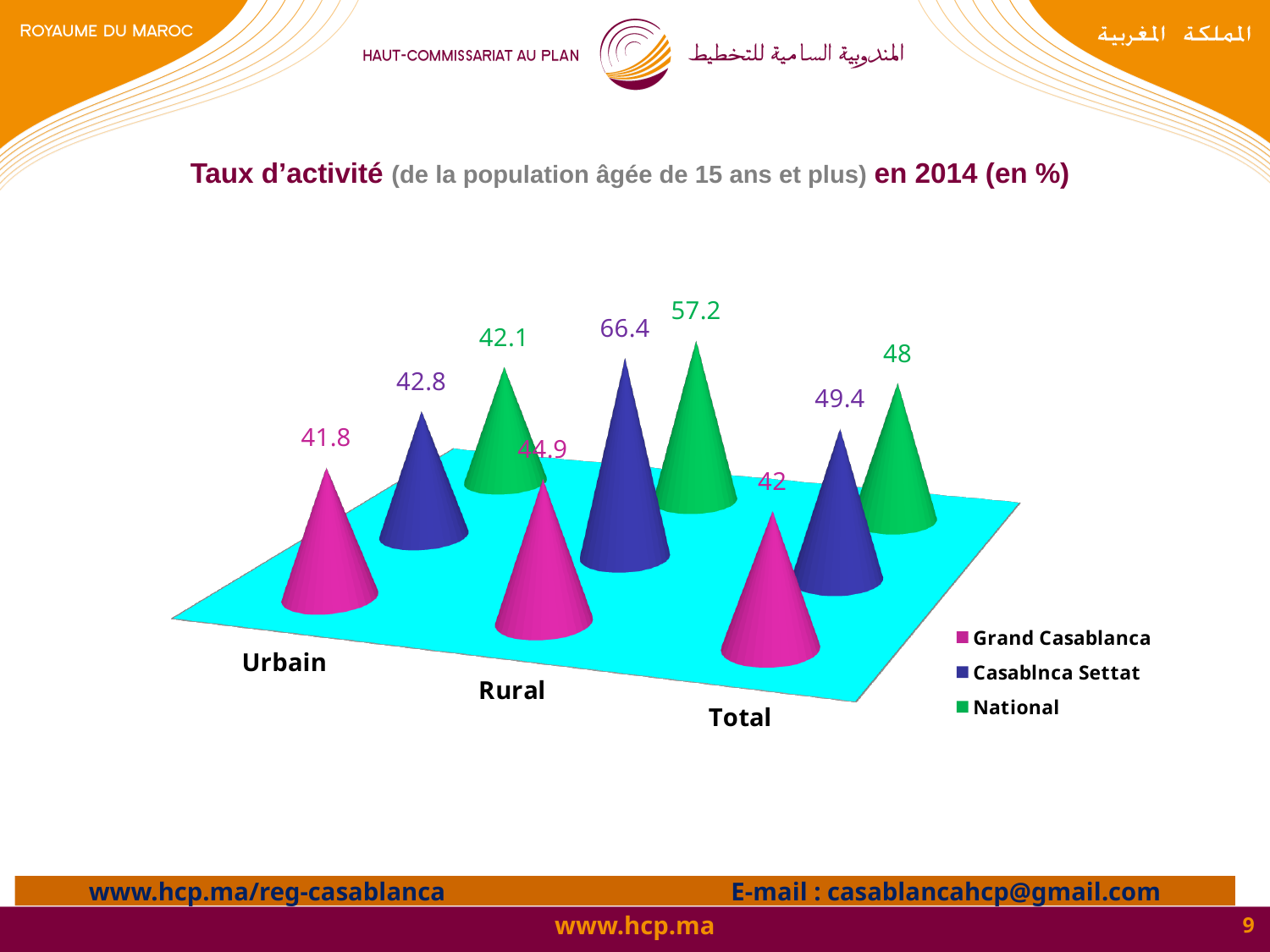
What is the value for Grand Casablanca in the Total category? 42 What is the difference between the Casablnca Settat and National values in the Rural category? 9.2 What is the value for Grand Casablanca in the Urbain category? 41.8 Which colour represents the National series in the legend? Green What kind of chart is shown on the slide? 3D bar chart (cone-shaped bars) How many series does the legend list? 3 Which category has the highest value for the Casablnca Settat series? Rural What is the value for Casablnca Settat in the Rural category? 66.4 What is the National value for the Total category? 48 How many categories are shown on the x axis? 3 Which category has the lowest value for the National series? Urbain Which is larger in the Total category: Casablnca Settat or Grand Casablanca? Casablnca Settat